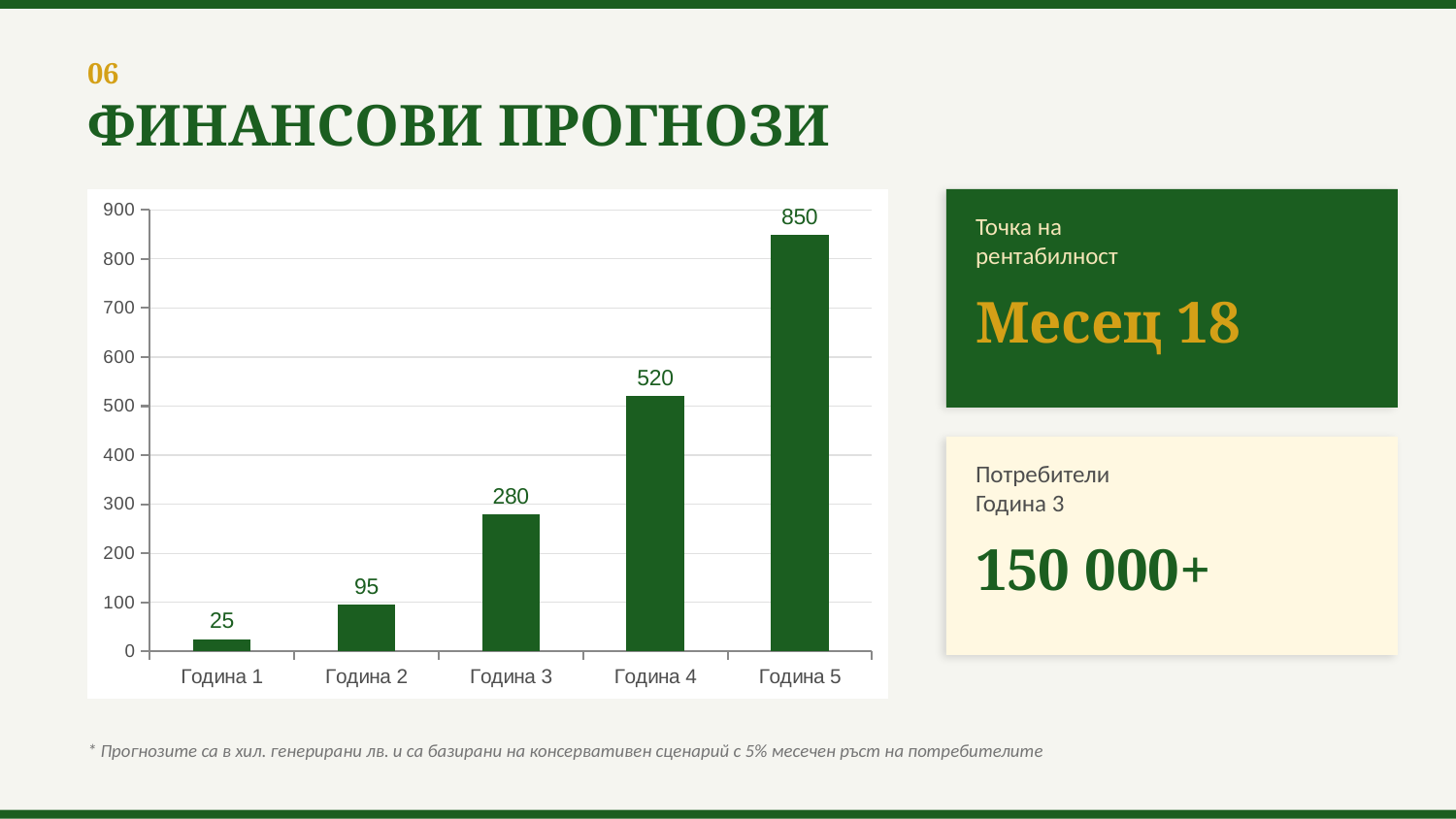
Is the value for Година 4 greater or less than 500? greater Which category has the highest value? Година 5 What is the difference between the values for Година 2 and Година 1? 70 What kind of chart is shown on the slide? bar chart Do the values rise or fall from Година 1 to Година 5? rise How many categories are shown on the x axis? 5 What is the value for Година 1? 25 Which is larger, the value for Година 3 or the value for Година 4? Година 4 What is the difference between the values for Година 5 and Година 4? 330 Which category has the lowest value? Година 1 What is the value for Година 3? 280 What is the value for Година 5? 850